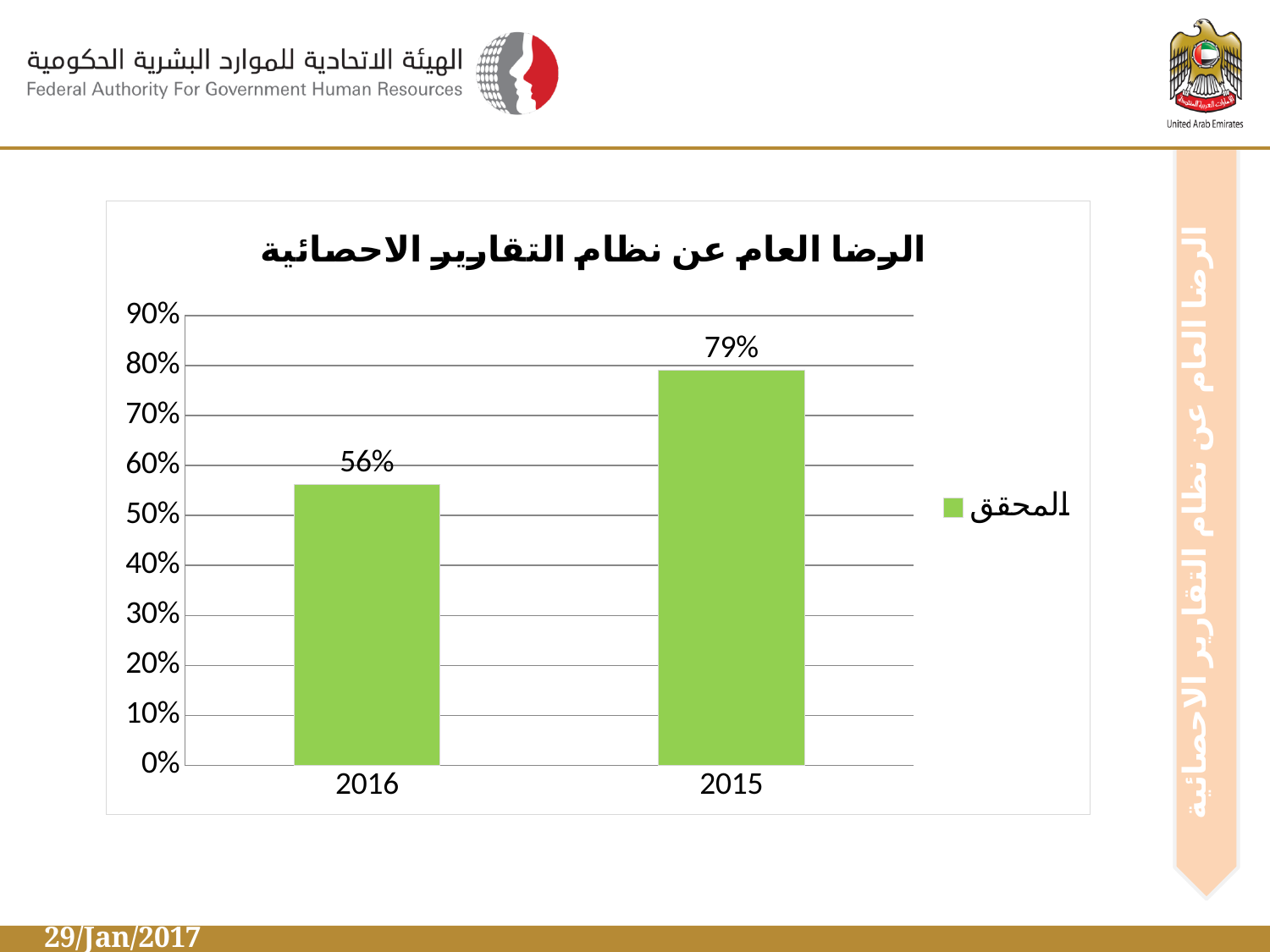
Which year has the lowest value? 2016 Is the value for 2016 greater or less than 60%? less Which is larger, the value for 2016 or the value for 2015? 2015 How many series does the legend list? 1 Which year has the highest value? 2015 What is the value for 2016? 56% How many categories are shown on the x axis? 2 What is the value for 2015? 79% Is the value for 2015 greater or less than 70%? greater What kind of chart is shown on the slide? bar chart What is the difference between the values for 2015 and 2016? 23% What is the title of the chart? الرضا العام عن نظام التقارير الاحصائية